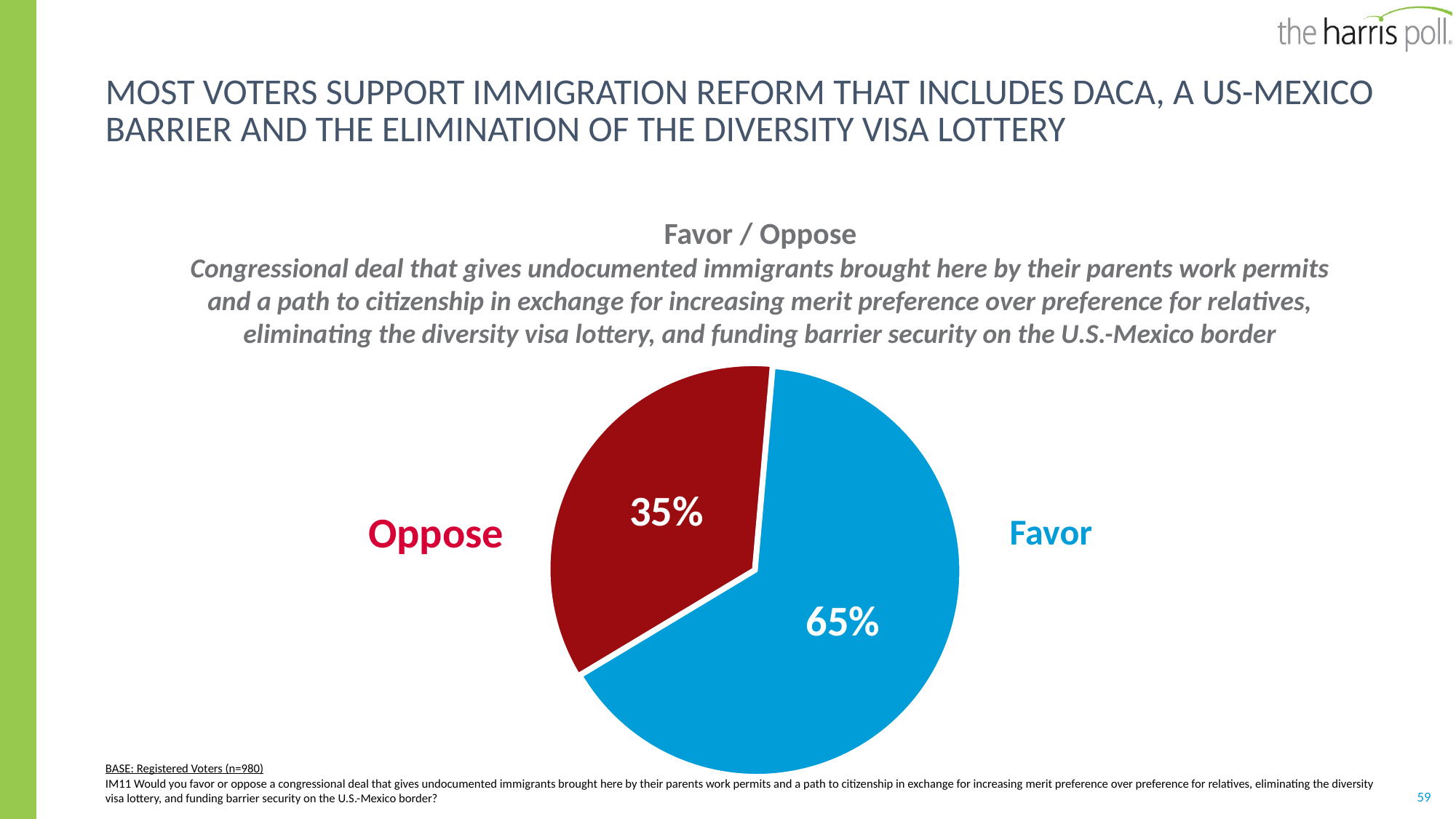
What colour is the Oppose slice of the pie? red Is the share for Oppose larger or smaller than the share for Favor? smaller What is the title shown above the pie chart? Favor / Oppose Which response has the smaller share of the pie? Oppose Is the share for Favor greater or less than 50%? greater What share of the pie does the Favor slice represent? 65% What kind of chart is shown on the slide? pie chart How many slices does the pie chart have? 2 What percentage of voters oppose the congressional deal? 35% Which response has the larger share of the pie, Favor or Oppose? Favor What percentage of voters favor the congressional deal? 65% What is the difference in percentage points between Favor and Oppose? 30